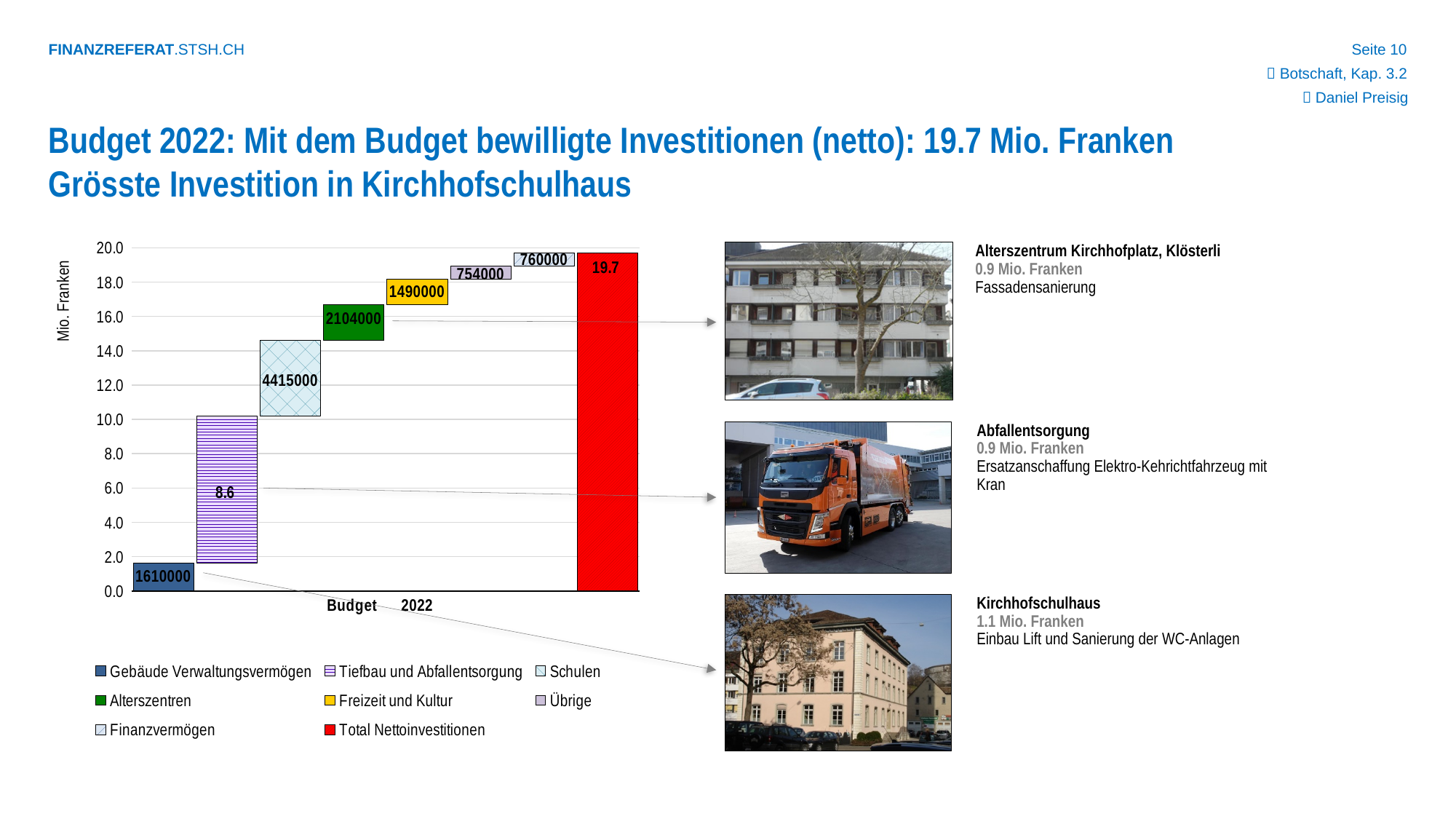
What value is printed on the Total Nettoinvestitionen bar? 19.7 What is the label on the vertical axis of the chart? Mio. Franken What value is shown for Alterszentren? 2104000 What is the data label on the Gebäude Verwaltungsvermögen segment? 1610000 What value is printed on the Tiefbau und Abfallentsorgung segment? 8.6 How many series does the legend list? 8 Which investment category (excluding the total) has the largest segment? Tiefbau und Abfallentsorgung What is the data label on the Schulen segment? 4415000 What kind of chart is shown on the slide? Bar chart Which is larger, the Freizeit und Kultur segment or the Alterszentren segment? Alterszentren What is the difference between the Schulen value and the Alterszentren value? 2311000 Which investment category has the smallest segment? Übrige